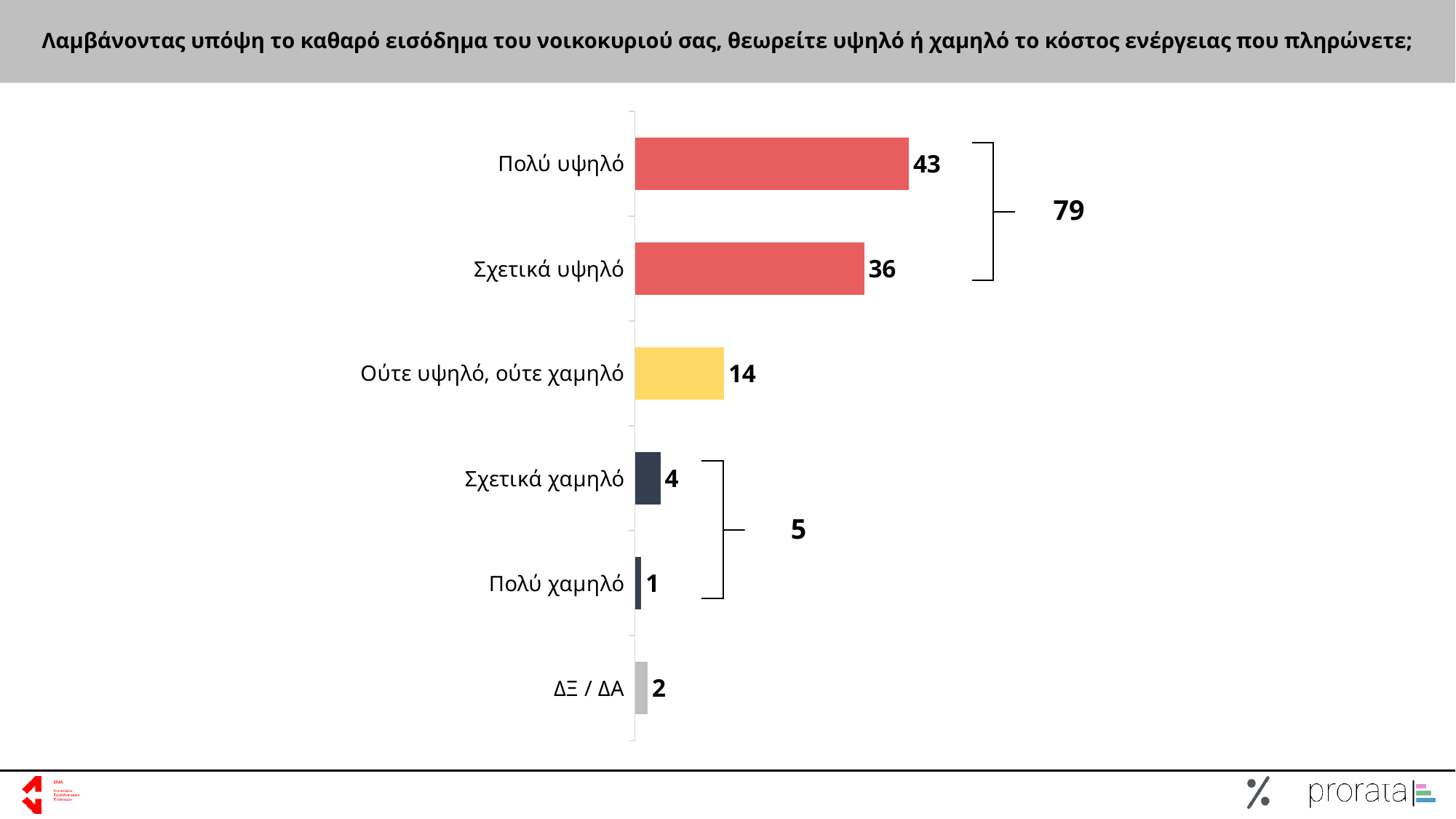
What is the difference between the values for Πολύ υψηλό and Σχετικά υψηλό? 7 Which category has the lowest value? Πολύ χαμηλό What is the value for ΔΞ / ΔΑ? 2 Which is larger, the value for Ούτε υψηλό, ούτε χαμηλό or the value for Σχετικά χαμηλό? Ούτε υψηλό, ούτε χαμηλό Which category has the highest value? Πολύ υψηλό What is the value for Σχετικά υψηλό? 36 What is the value for Πολύ χαμηλό? 1 How many categories are shown in the chart? 6 What combined value is shown by the bracket grouping Σχετικά χαμηλό and Πολύ χαμηλό? 5 What kind of chart is shown on the slide? Bar chart What is the value for Ούτε υψηλό, ούτε χαμηλό? 14 What is the value for Πολύ υψηλό? 43